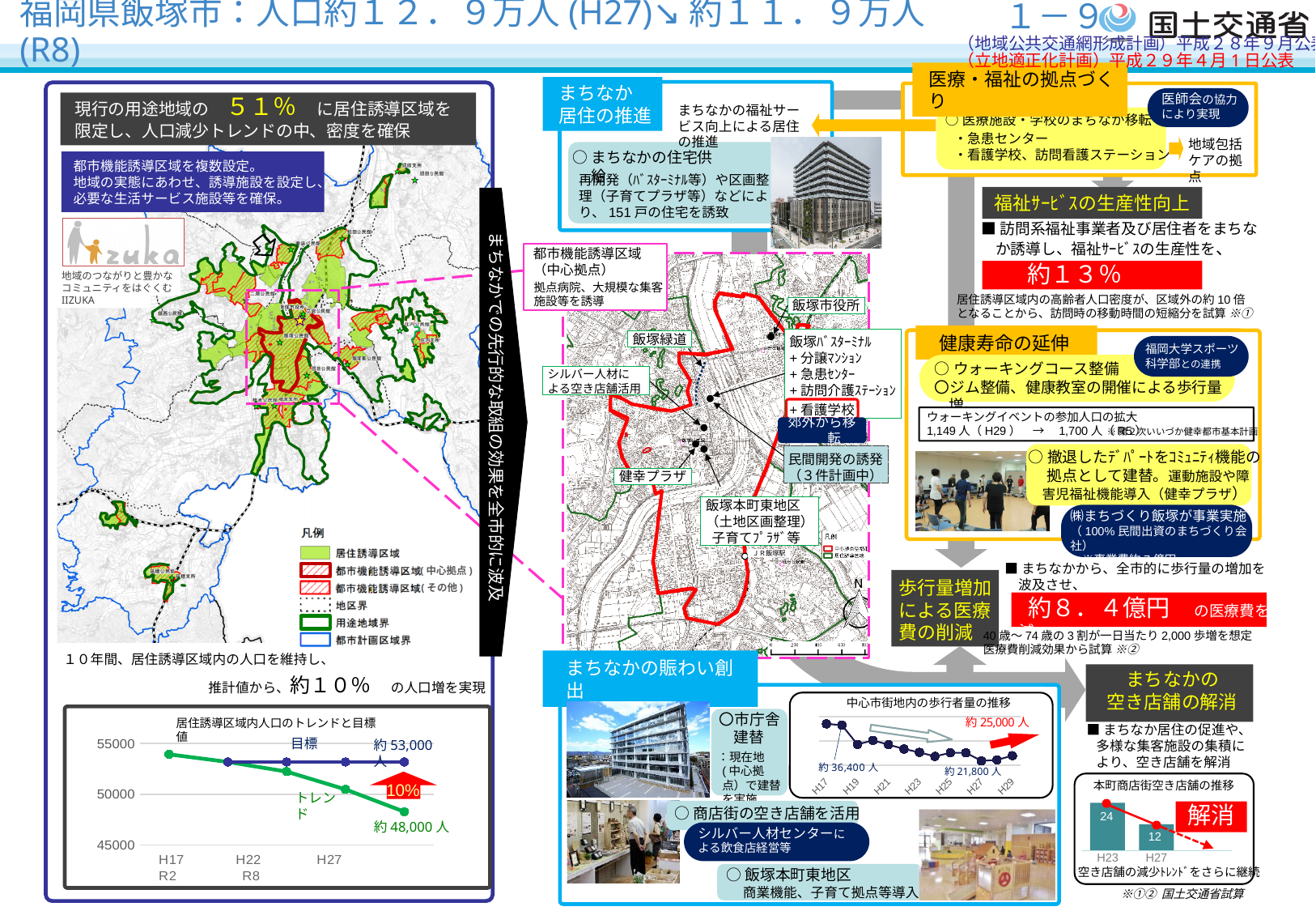
How many series are plotted in the 居住誘導区域内人口のトレンドと目標値 chart? 2 In the 本町商店街空き店舗の推移 chart, what is the difference between the H23 and H27 values? 12 In the 居住誘導区域内人口のトレンドと目標値 chart, is the トレンド value at R8 greater or less than 50000? less What kind of chart is the 本町商店街空き店舗の推移 chart at the bottom right? bar chart How many bars are in the 本町商店街空き店舗の推移 chart? 2 What kind of chart is the 居住誘導区域内人口のトレンドと目標値 chart at the bottom left? line chart In the 居住誘導区域内人口のトレンドと目標値 chart, does the トレンド line rise or fall from H17 to R8? fall In the 本町商店街空き店舗の推移 chart, what is the value for H27? 12 In the 本町商店街空き店舗の推移 chart, what is the value for H23? 24 In the 中心市街地内の歩行者量の推移 chart, do the plotted values rise or fall from H17 to H27? fall In the 居住誘導区域内人口のトレンドと目標値 chart, is the 目標 value at R8 greater or less than 50000? greater In the 本町商店街空き店舗の推移 chart, which year has the higher value, H23 or H27? H23